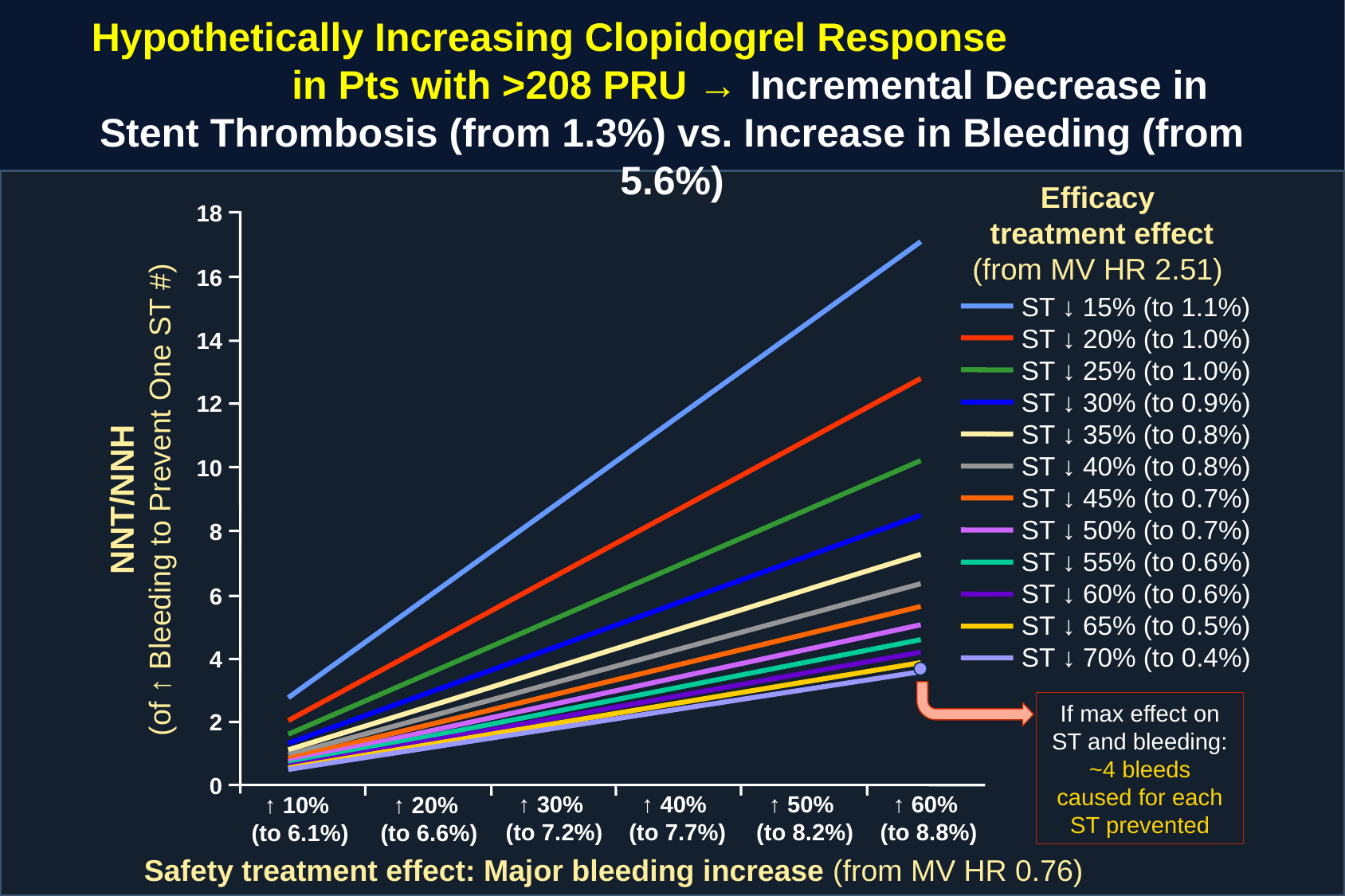
What is the label on the y axis of the chart? NNT/NNH (of ↑ Bleeding to Prevent One ST #) Is the value for ST ↓ 20% (to 1.0%) at ↑60% (to 8.8%) greater or less than 12? greater What kind of chart is shown on the slide? line chart Which series has the highest NNT/NNH value at ↑60% (to 8.8%)? ST ↓ 15% (to 1.1%) What is the title of the legend on the chart? Efficacy treatment effect (from MV HR 2.51) Is the value for ST ↓ 70% (to 0.4%) at ↑60% (to 8.8%) greater or less than 4? less Is the value for ST ↓ 15% (to 1.1%) at ↑60% (to 8.8%) greater or less than 16? greater Do the NNT/NNH values rise or fall as the bleeding increase moves from ↑10% to ↑60%? rise Which series has the lowest NNT/NNH value at ↑60% (to 8.8%)? ST ↓ 70% (to 0.4%) At ↑60% (to 8.8%), which is larger: the value for ST ↓ 20% (to 1.0%) or ST ↓ 25% (to 1.0%)? ST ↓ 20% (to 1.0%) How many series does the legend list? 12 How many categories are shown along the x axis? 6